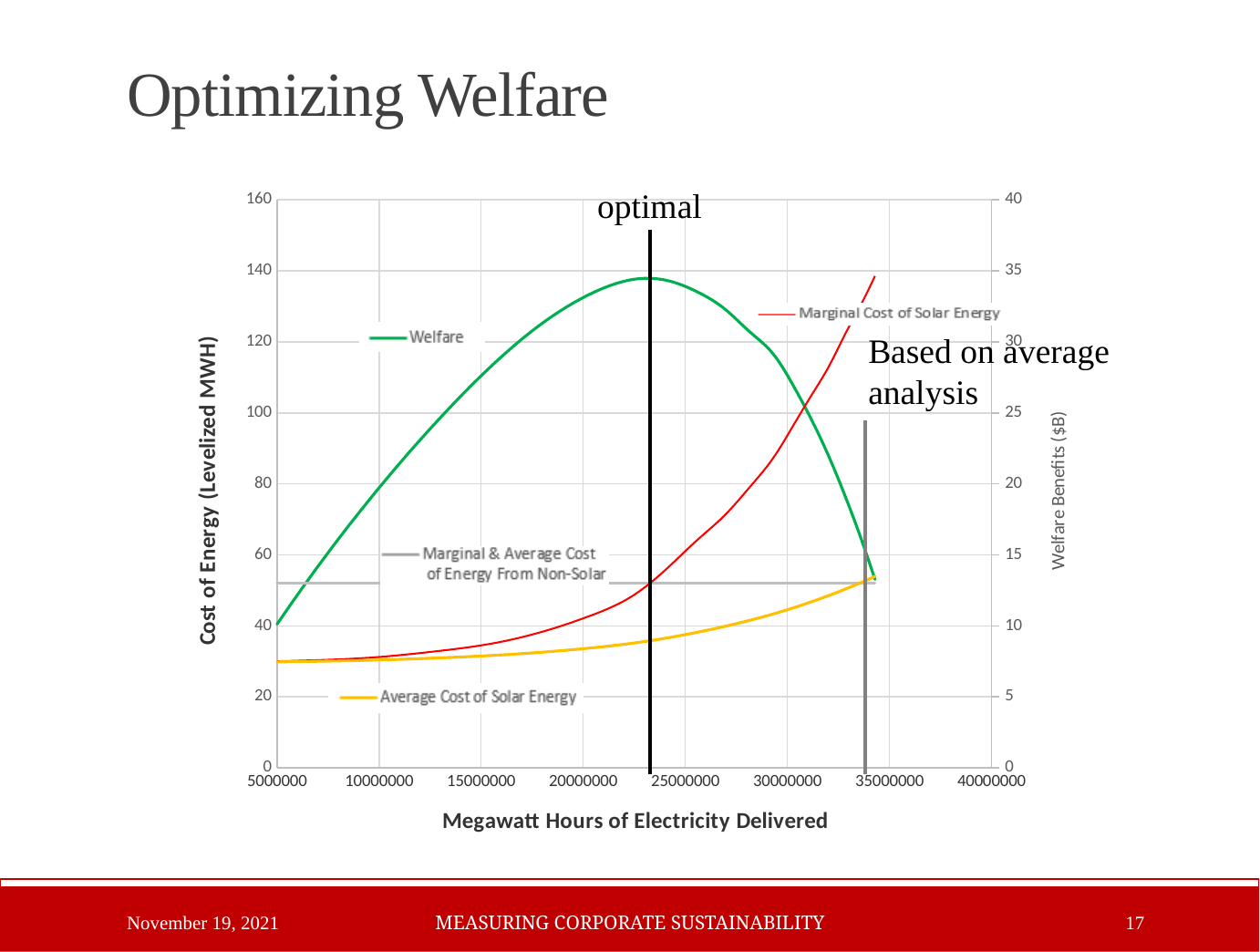
Does the Average Cost of Solar Energy line rise or fall as megawatt hours increase along the x axis? rise What is the title of the right-hand y axis? Welfare Benefits ($B) Is the Average Cost of Solar Energy at 5000000 megawatt hours greater or less than 40 on the left axis? less Is the Marginal Cost of Solar Energy at 35000000 megawatt hours greater or less than 120 on the left axis? greater What is the title of the x axis? Megawatt Hours of Electricity Delivered What kind of chart is shown on the slide? line chart At 35000000 megawatt hours, which is higher: the Marginal Cost of Solar Energy or the Average Cost of Solar Energy? Marginal Cost of Solar Energy Is the Marginal & Average Cost of Energy From Non-Solar greater or less than 60 on the left axis? less How many series are labelled on the chart? 4 Does the Marginal Cost of Solar Energy line rise or fall as megawatt hours increase along the x axis? rise